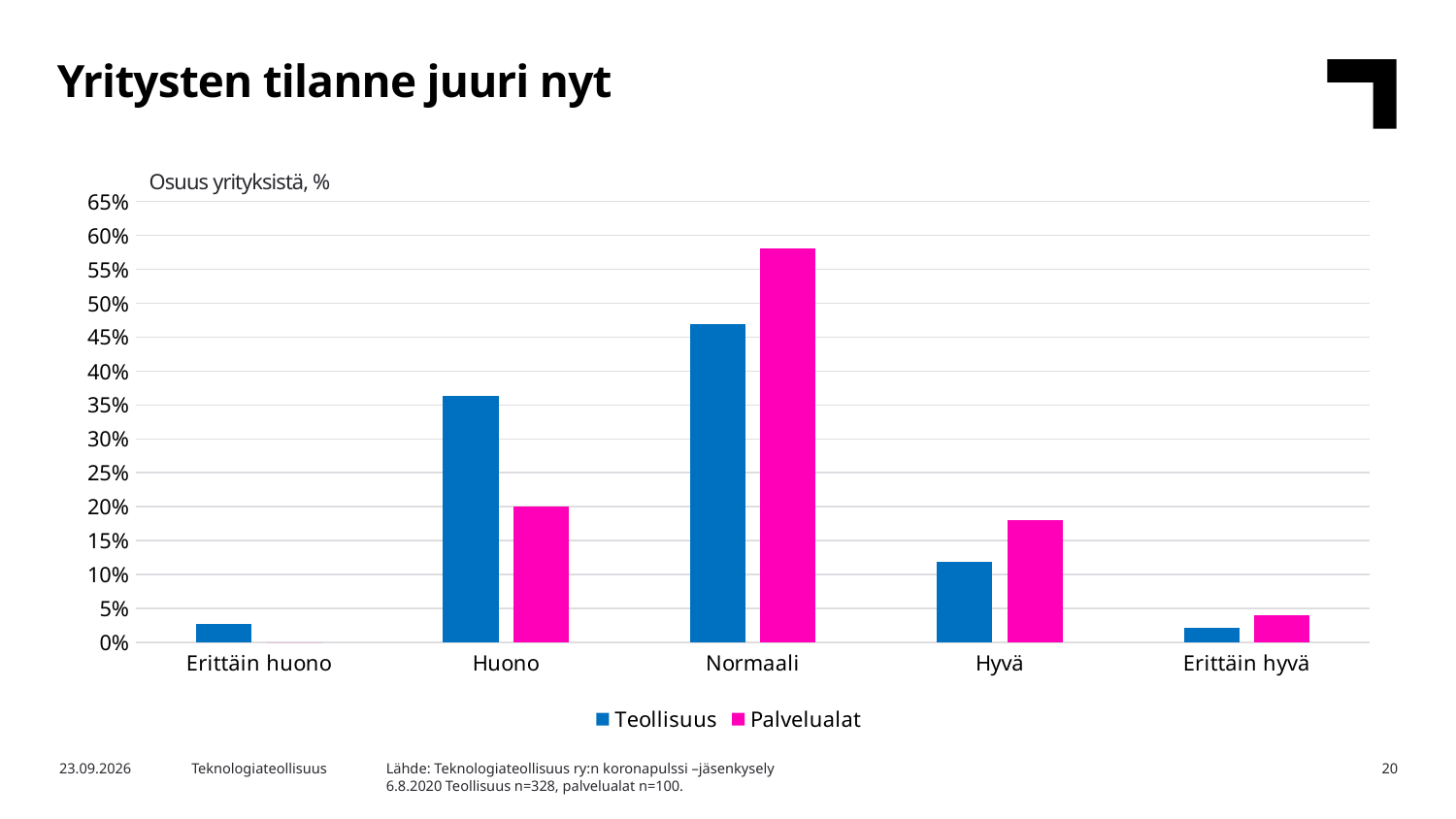
Is the value for Teollisuus in the Normaali category greater or less than 50%? less Which category has the highest value for Teollisuus? Normaali In the Huono category, which series has the larger value, Teollisuus or Palvelualat? Teollisuus What is the label shown above the vertical axis of the chart? Osuus yrityksistä, % What type of chart is shown on the slide? bar chart Is the value for Palvelualat in the Hyvä category greater or less than 25%? less How many categories are shown on the x axis? 5 Which category has the highest value for Palvelualat? Normaali How many series does the legend list? 2 Is the value for Palvelualat in the Normaali category greater or less than 50%? greater Which category has the lowest value for Palvelualat? Erittäin huono